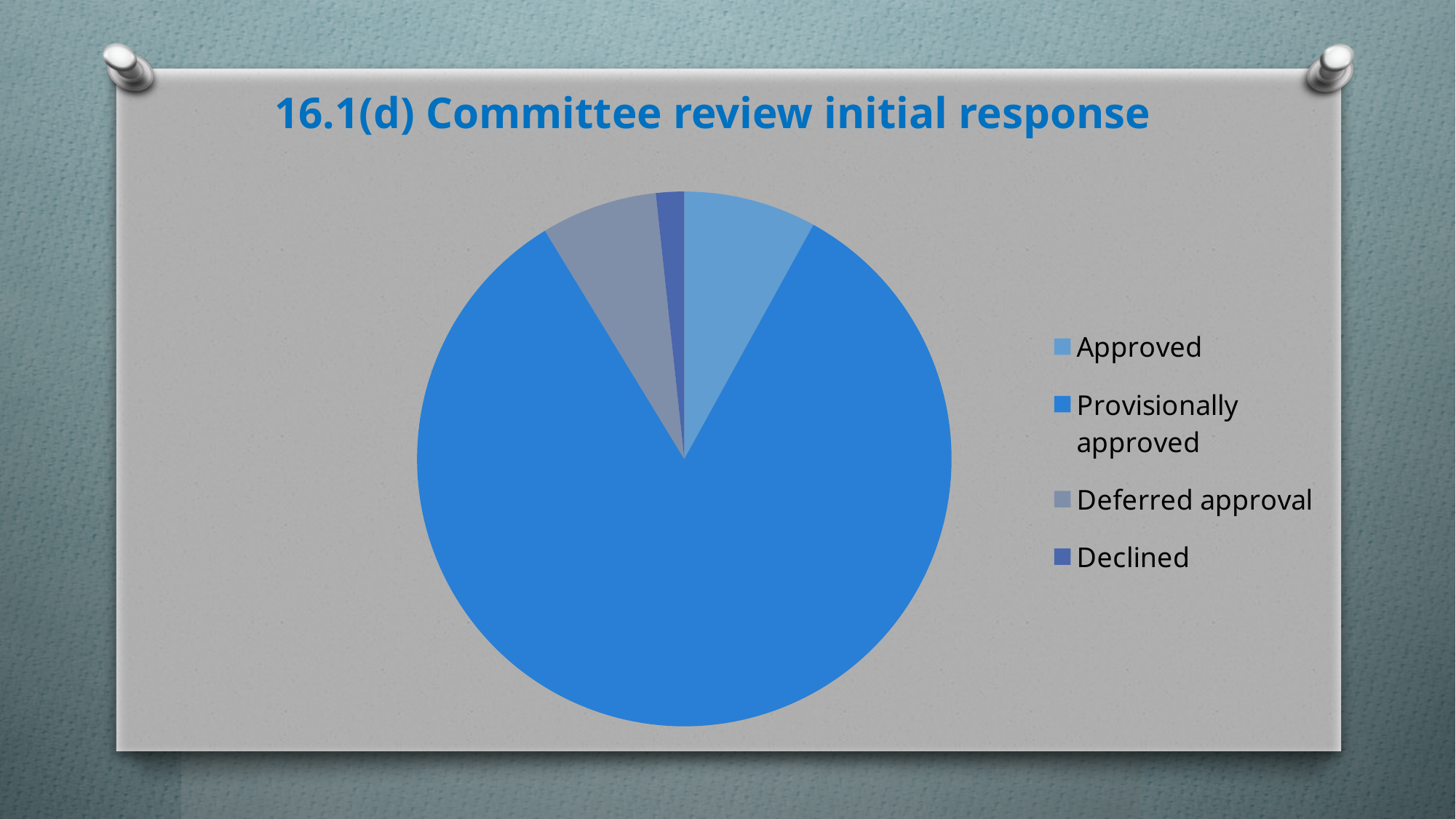
Which is larger, the slice for Deferred approval or the slice for Declined? Deferred approval Which legend entry is listed last? Declined Does the Provisionally approved slice make up more or less than half of the pie? more How many categories does the pie chart show? 4 What is the title of the chart? 16.1(d) Committee review initial response Which is larger, the slice for Provisionally approved or the slice for Approved? Provisionally approved What kind of chart is shown on the slide? pie chart Which is larger, the slice for Provisionally approved or the slice for Deferred approval? Provisionally approved Which category has the largest slice of the pie? Provisionally approved Which category has the smallest slice of the pie? Declined